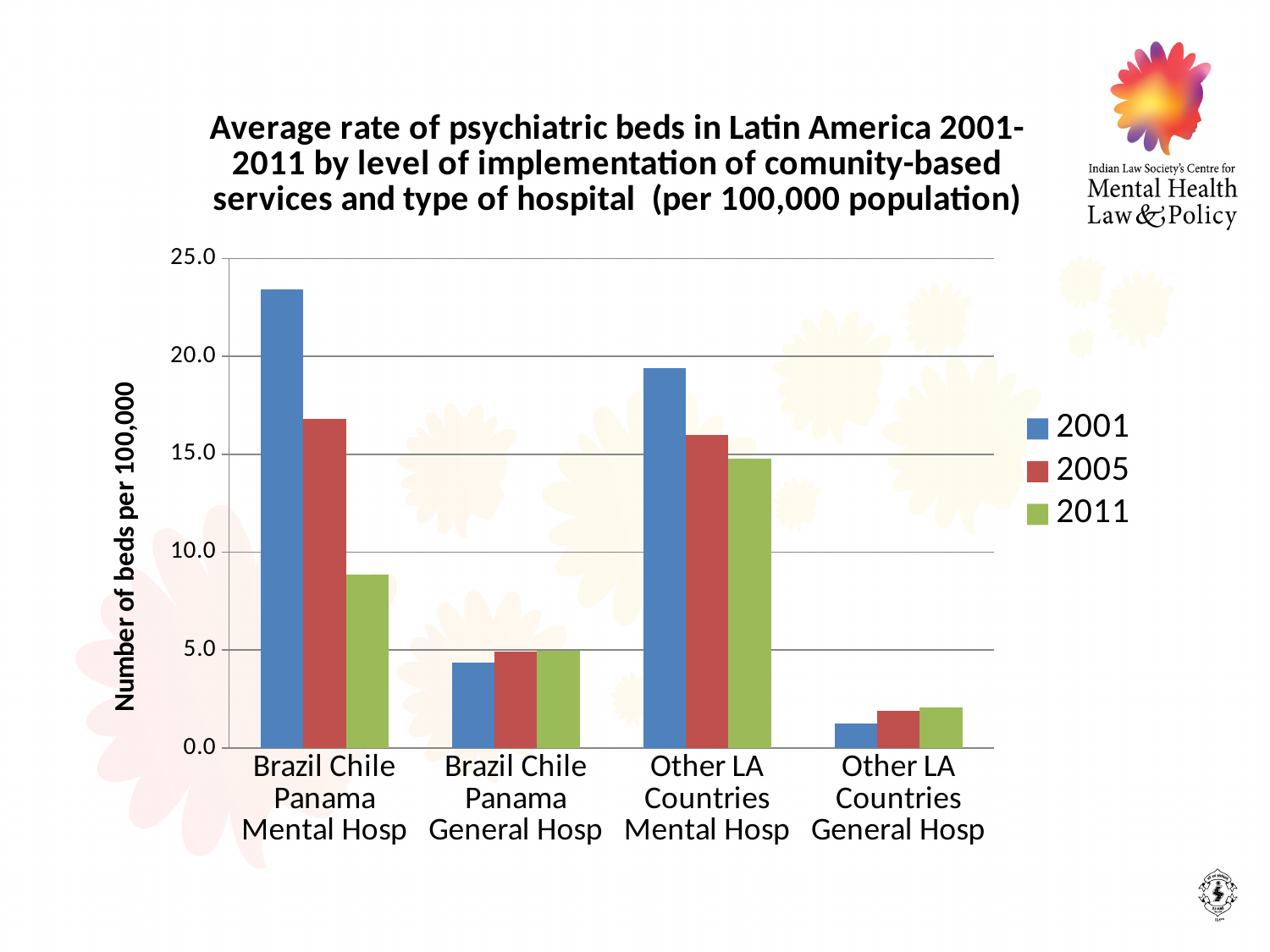
For Brazil Chile Panama Mental Hosp, which is larger: the 2001 value or the 2011 value? 2001 How many categories are shown on the x axis? 4 For 2001, which is larger: Brazil Chile Panama Mental Hosp or Other LA Countries Mental Hosp? Brazil Chile Panama Mental Hosp How many series does the legend list? 3 Is the 2005 value for Other LA Countries Mental Hosp greater or less than 15.0? greater Which category has the highest value for 2001? Brazil Chile Panama Mental Hosp Is the 2011 value for Brazil Chile Panama Mental Hosp greater or less than 10.0? less What kind of chart is shown on the slide? bar chart Do the values for Brazil Chile Panama Mental Hosp rise or fall from 2001 to 2005 to 2011? fall Which category has the lowest value for 2001? Other LA Countries General Hosp What is the title of the y axis? Number of beds per 100,000 Is the 2001 value for Brazil Chile Panama Mental Hosp greater or less than 20.0? greater